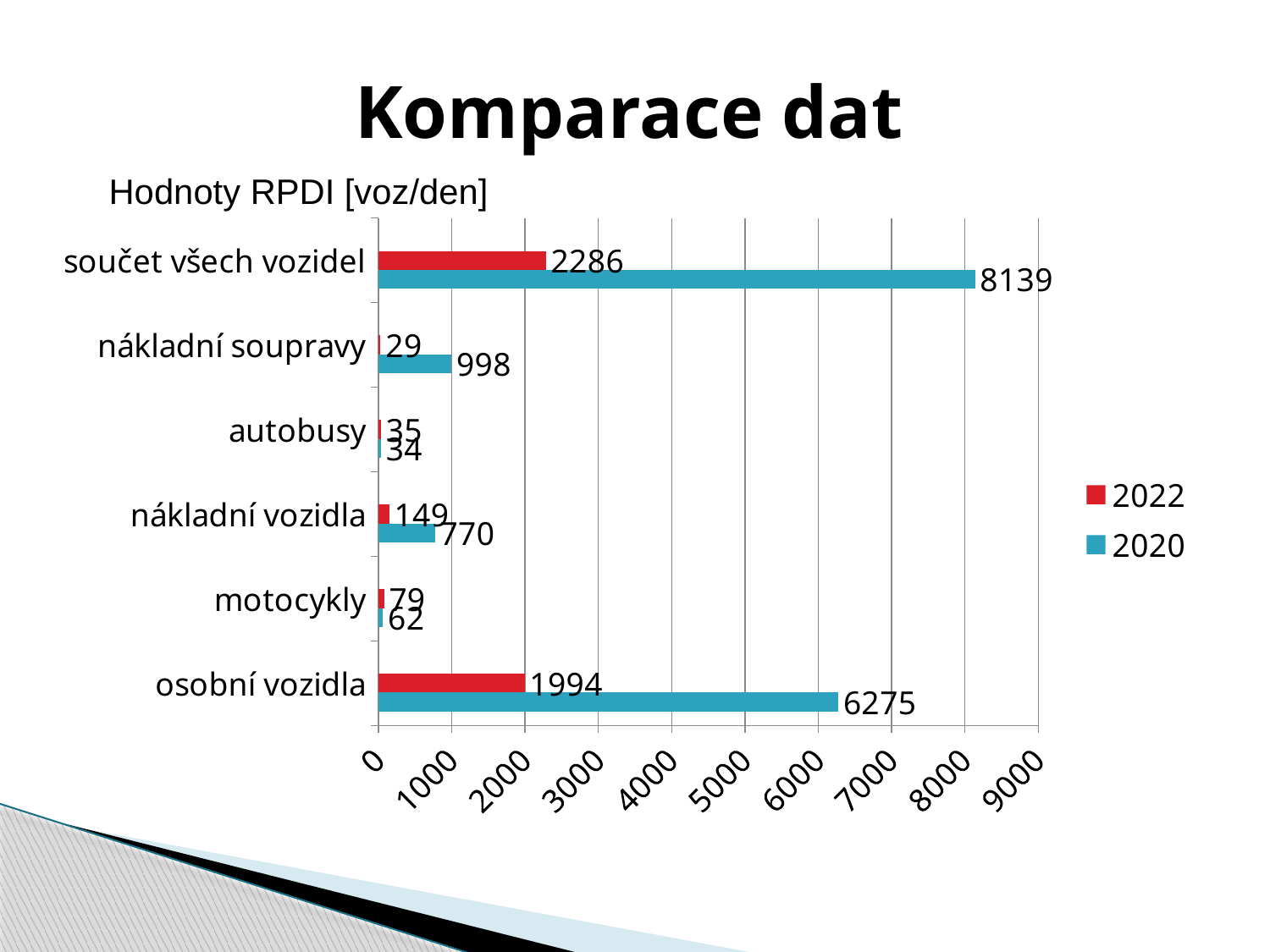
What is the 2022 value for osobní vozidla? 1994 What kind of chart is shown on the slide? bar chart Which is larger for motocykly, the 2022 value or the 2020 value? 2022 How many series does the legend list? 2 What is the title of the chart? Hodnoty RPDI [voz/den] What is the difference between the 2020 and 2022 values for osobní vozidla? 4281 Which category has the lowest 2022 value? nákladní soupravy What is the 2022 value for nákladní vozidla? 149 What is the 2020 value for nákladní soupravy? 998 What is the 2020 value for součet všech vozidel? 8139 How many categories are shown on the chart? 6 Which category has the highest 2020 value? součet všech vozidel